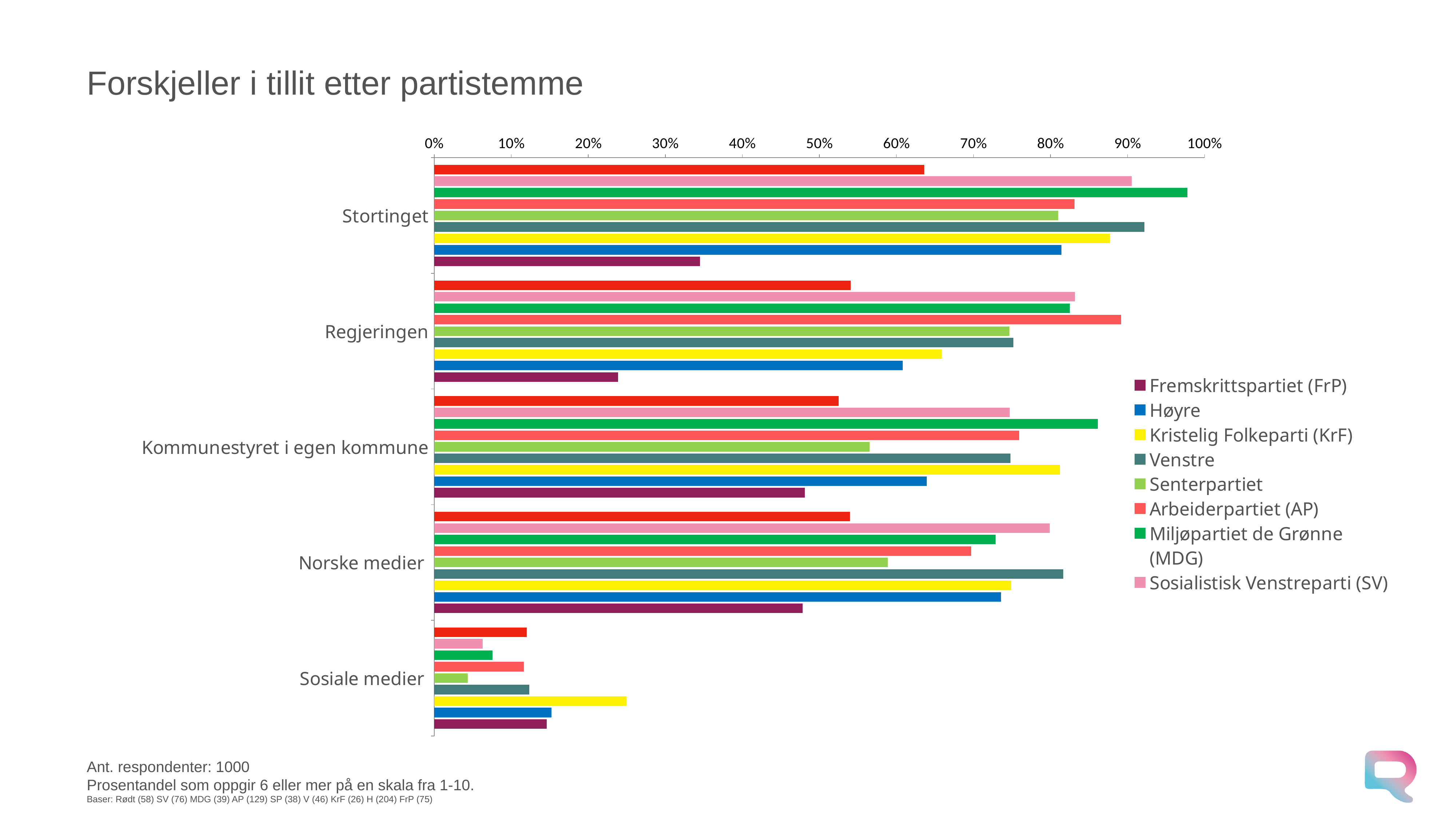
Which party has the lowest value in the Stortinget category? Fremskrittspartiet (FrP) Is the value for Senterpartiet in the Sosiale medier category greater or less than 10%? less What is the title of the slide? Forskjeller i tillit etter partistemme Is the value for Kristelig Folkeparti (KrF) in the Sosiale medier category greater or less than 20%? greater Is the value for Miljøpartiet de Grønne (MDG) in the Stortinget category greater or less than 90%? greater In the Regjeringen category, which is larger: the value for Arbeiderpartiet (AP) or the value for Høyre? Arbeiderpartiet (AP) How many series does the legend list? 8 Which party has the highest value in the Sosiale medier category? Kristelig Folkeparti (KrF) How many categories are shown on the vertical axis of the chart? 5 In the Kommunestyret i egen kommune category, which is larger: the value for Miljøpartiet de Grønne (MDG) or the value for Senterpartiet? Miljøpartiet de Grønne (MDG) What kind of chart is shown on the slide? bar chart